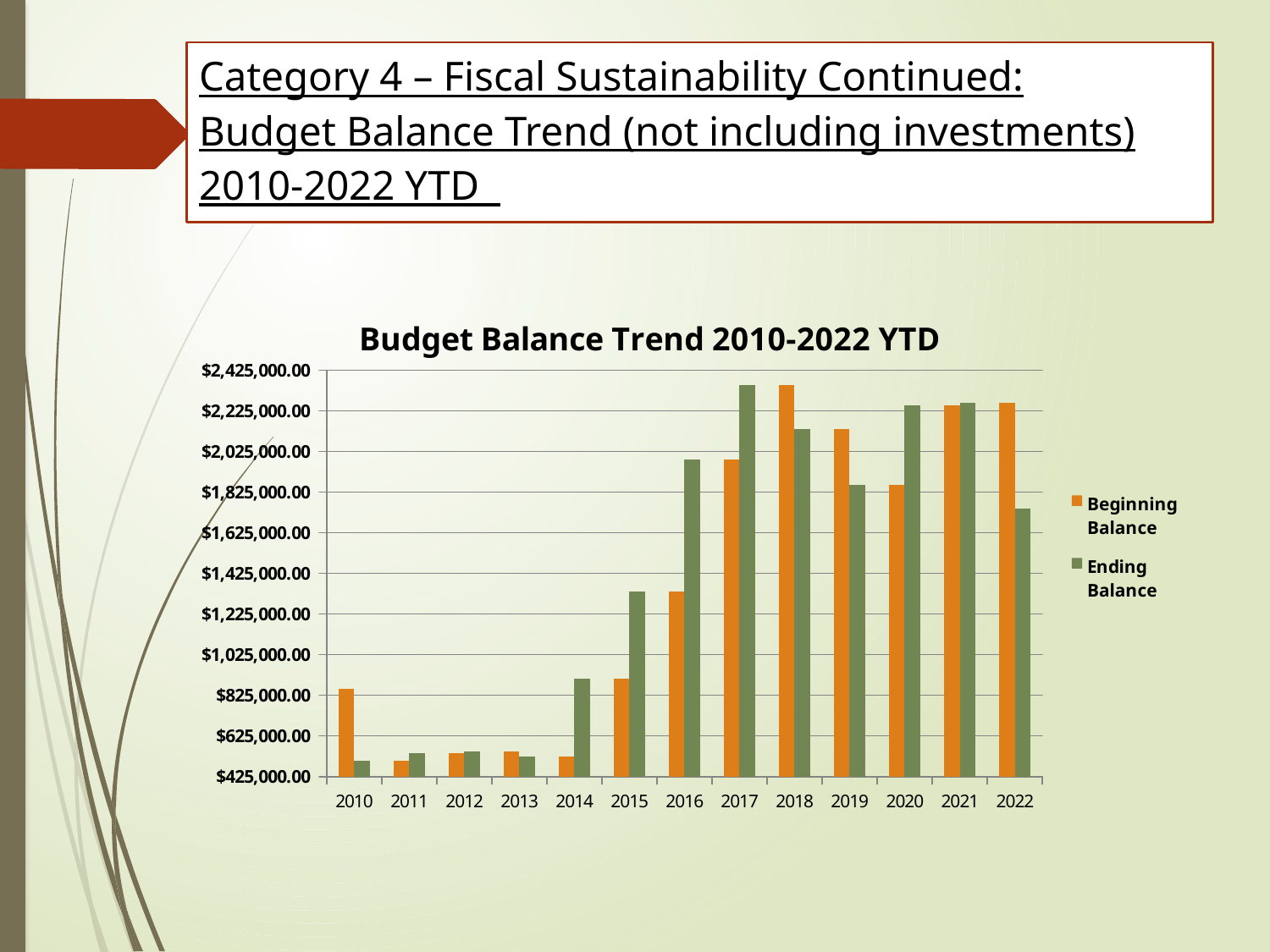
Is the Ending Balance for 2022 greater or less than $1,825,000.00? less What kind of chart is shown on the slide? Bar chart Is the Beginning Balance for 2010 greater or less than $625,000.00? greater How many series does the legend list in the Budget Balance Trend chart? 2 In 2022, which is larger, the Beginning Balance or the Ending Balance? Beginning Balance Which year has the highest Ending Balance? 2017 Which year has the highest Beginning Balance? 2018 Is the Ending Balance for 2016 greater or less than $1,825,000.00? greater In 2016, which is larger, the Beginning Balance or the Ending Balance? Ending Balance Does the Ending Balance rise or fall from 2013 to 2017? Rise How many years are shown on the x axis of the Budget Balance Trend chart? 13